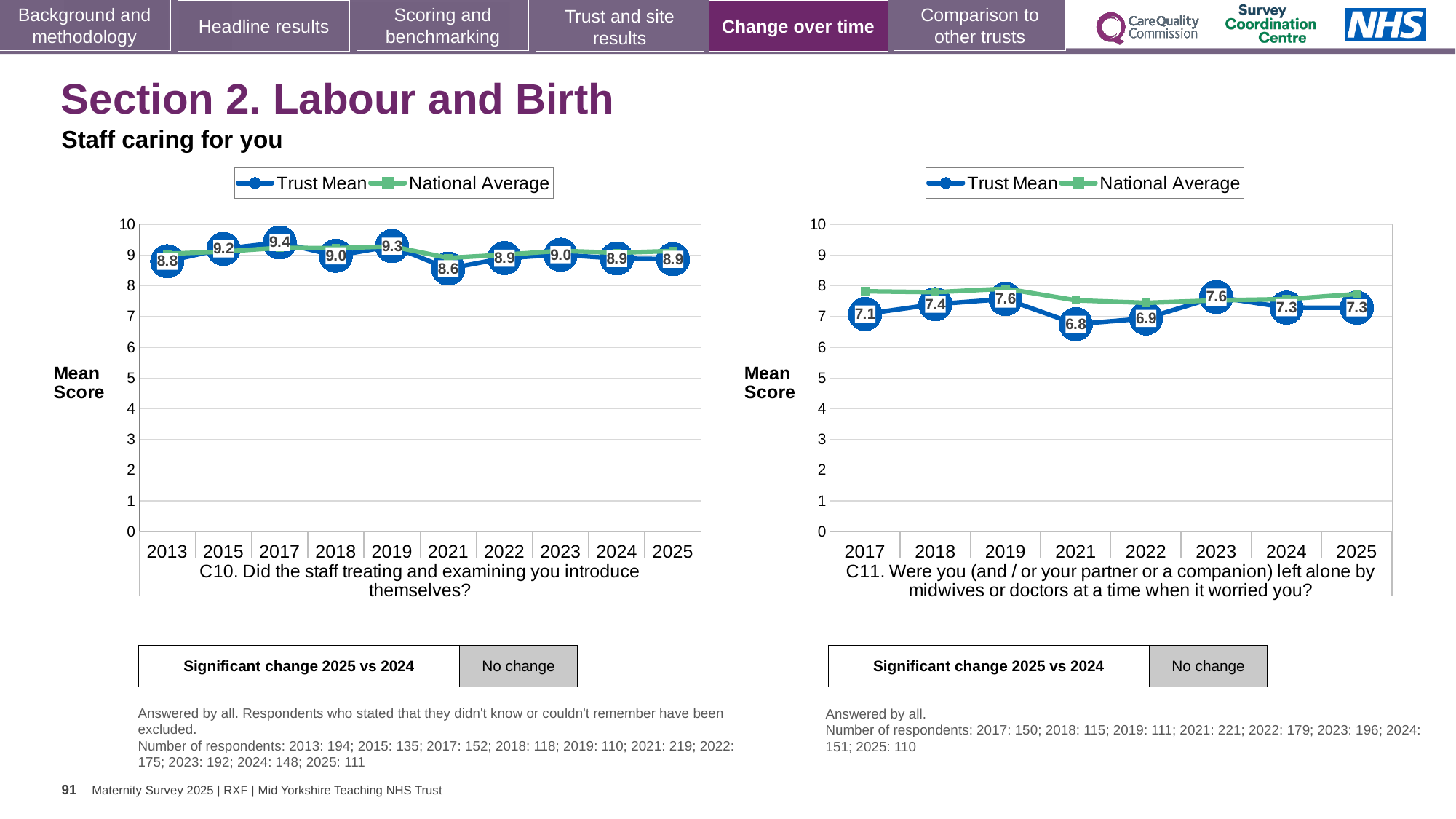
In the right chart (C11), what is the Trust Mean score for 2021? 6.8 In the left chart (C10), which year has the lowest Trust Mean score? 2021 In the left chart (C10), how many years are shown on the x axis? 10 In the left chart (C10), which year has the highest Trust Mean score? 2017 In the left chart (C10), what is the Trust Mean score for 2021? 8.6 How many series does the legend of the right chart (C11) list? 2 In the right chart (C11), is the Trust Mean score for 2018 larger or smaller than the score for 2019? smaller In the right chart (C11), is the National Average value for 2017 greater or less than 7? greater In the right chart (C11), which year has the lowest Trust Mean score? 2021 In the left chart (C10), what is the difference between the Trust Mean scores for 2017 and 2021? 0.8 In the right chart (C11), what is the Trust Mean score for 2025? 7.3 In the left chart (C10), what is the Trust Mean score for 2017? 9.4